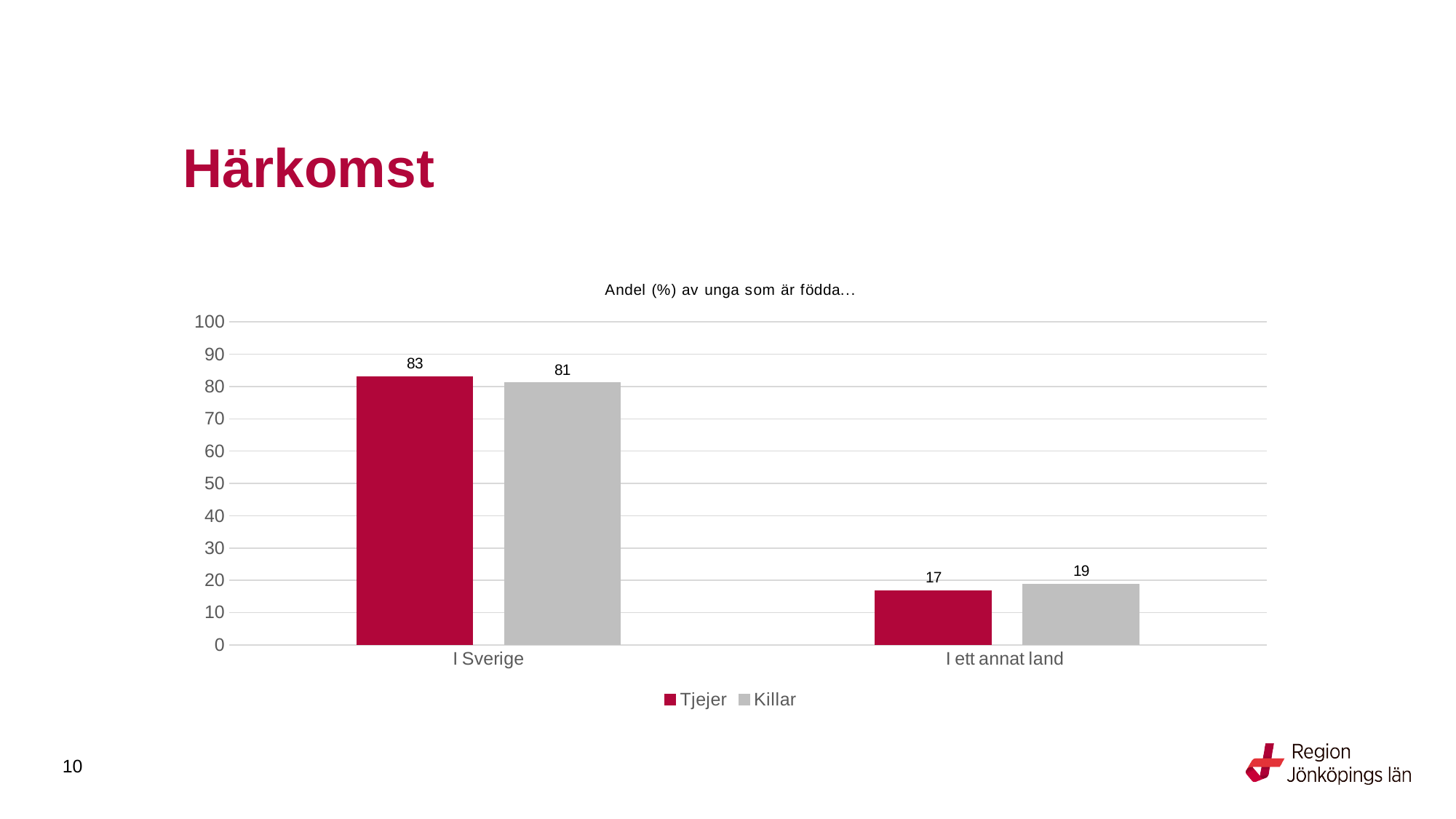
In the I ett annat land category, which series has the larger value, Tjejer or Killar? Killar How many series does the legend list? 2 What is the value for Tjejer in the I Sverige category? 83 What is the value for Killar in the I Sverige category? 81 What is the value for Tjejer in the I ett annat land category? 17 Which category has the highest value for Tjejer? I Sverige Which category has the lowest value for Killar? I ett annat land What is the difference between the Tjejer and Killar values in the I Sverige category? 2 What type of chart is shown on the slide? Bar chart What is the value for Killar in the I ett annat land category? 19 Is the value for Killar in the I Sverige category greater or less than 70? greater How many categories are shown on the x axis? 2